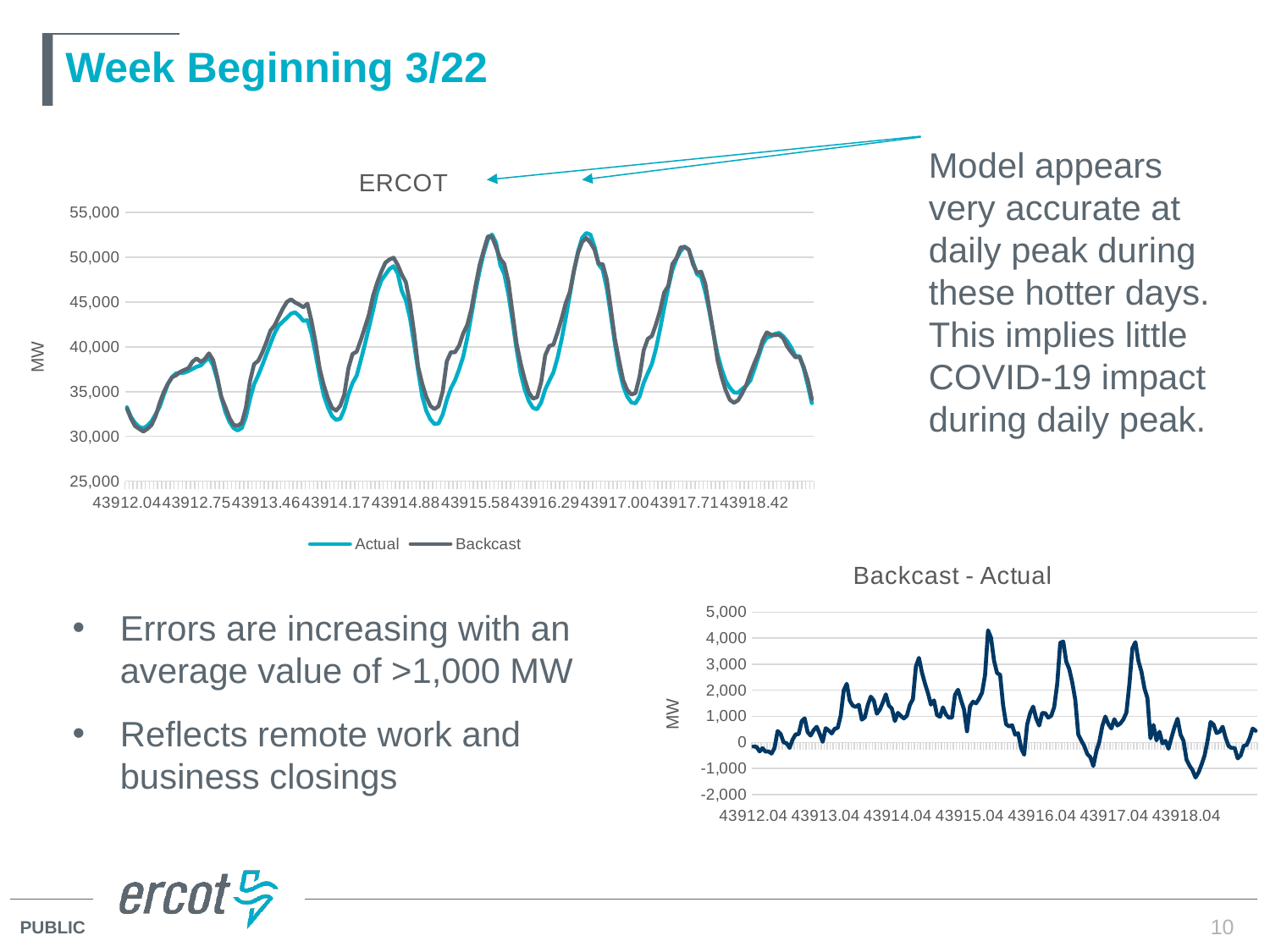
What kind of chart is the chart titled "ERCOT"? line chart What are the two series named in the legend of the "ERCOT" chart? Actual and Backcast How many series does the legend of the "ERCOT" chart list? 2 What kind of chart is the chart titled "Backcast - Actual"? line chart How many charts are shown on the slide? 2 In the "Backcast - Actual" chart, is the highest value of the line greater or less than 5,000? less In the "Backcast - Actual" chart, is the highest value of the line greater or less than 3,000? greater In the "Backcast - Actual" chart, is the lowest value of the line greater or less than 0? less What is the y-axis label on the "ERCOT" chart? MW